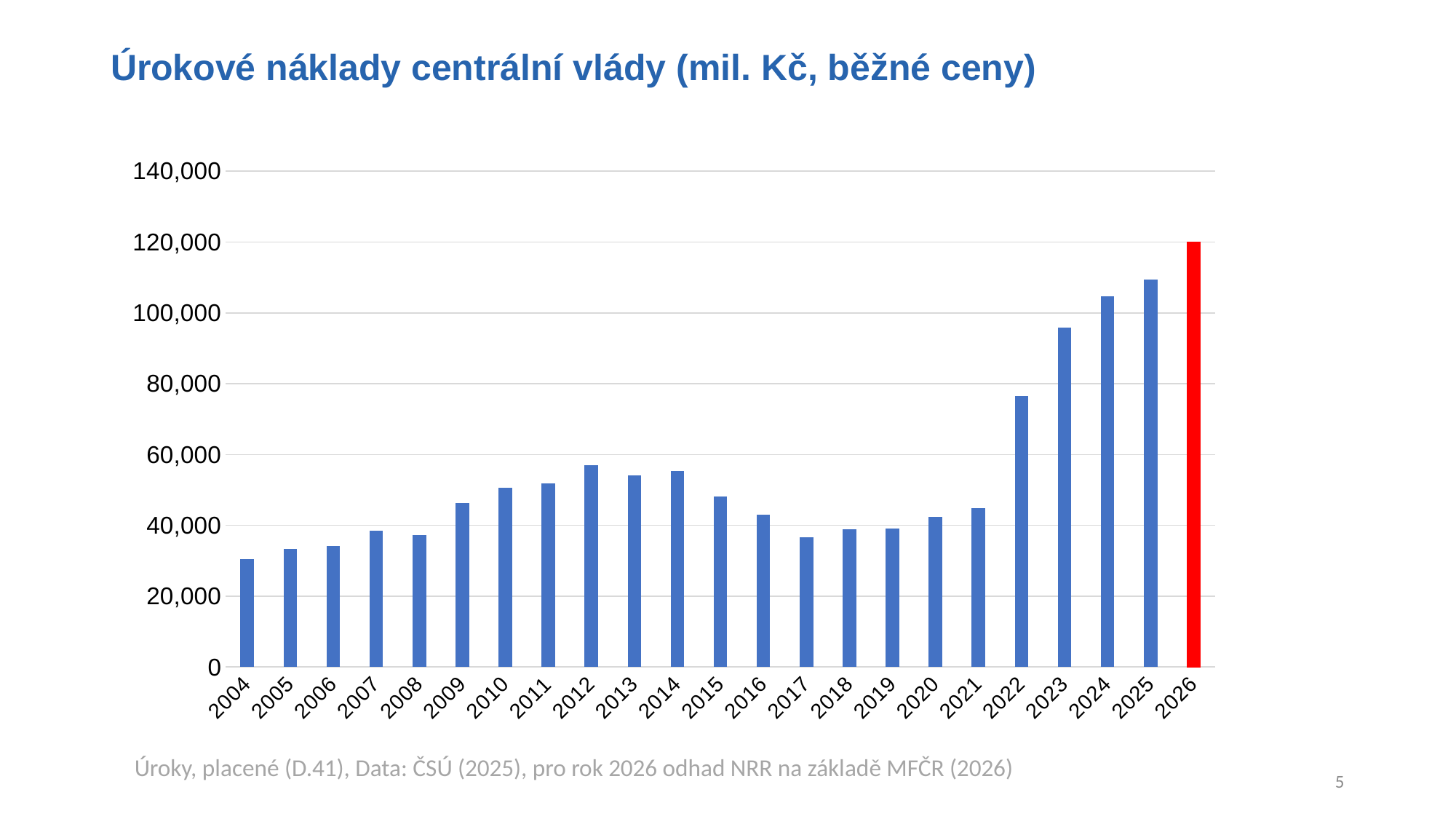
Is the value for 2023 greater or less than 80,000? greater What kind of chart is shown on the slide? bar chart Which year has the highest interest cost? 2026 What is the value for 2026? 120,000 Do the values rise or fall from 2022 to 2026? rise Is the value for 2022 greater or less than 60,000? greater Which year has the lowest interest cost? 2004 Is the value for 2025 greater or less than 100,000? greater How many years are plotted on the x axis? 23 What colour is the bar for 2026? red Which year has the larger value, 2014 or 2015? 2014